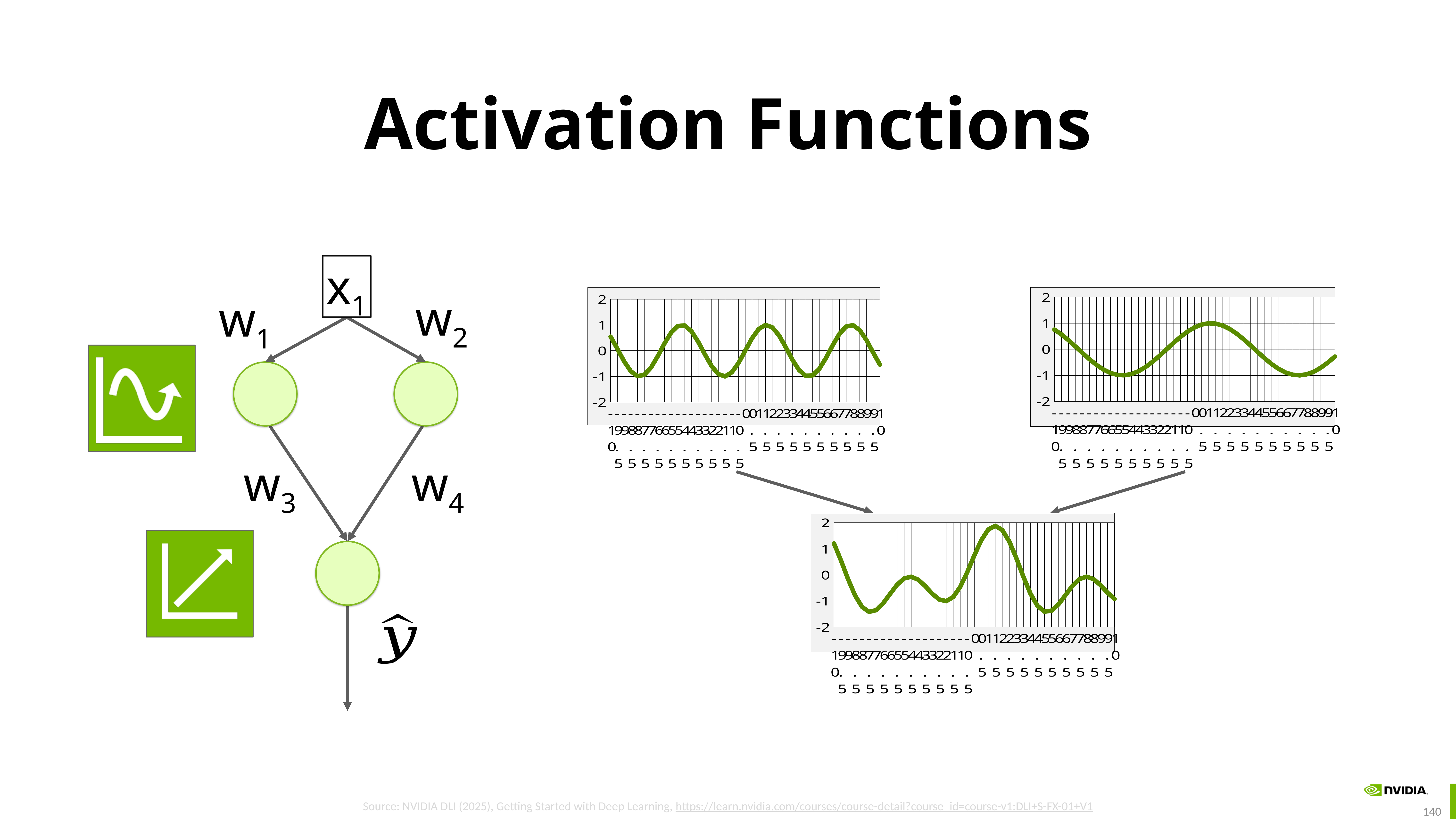
Which chart reaches a higher peak value, the top-right chart or the bottom chart? the bottom chart What kind of chart is the top-left chart on the slide? line chart How many charts are shown on the slide? 3 In the top-left chart, what is the highest value shown on the y axis? 2 What kind of chart is the bottom chart on the slide? line chart In the top-right chart, is the highest point of the line greater or less than 2? less In the bottom chart, what is the lowest value shown on the y axis? -2 How many full peaks does the line in the top-left chart show? 3 In the bottom chart, is the highest point of the line greater or less than 1? greater In the top-left chart, is the lowest point of the line greater or less than 0? less How many full peaks does the line in the top-right chart show? 1